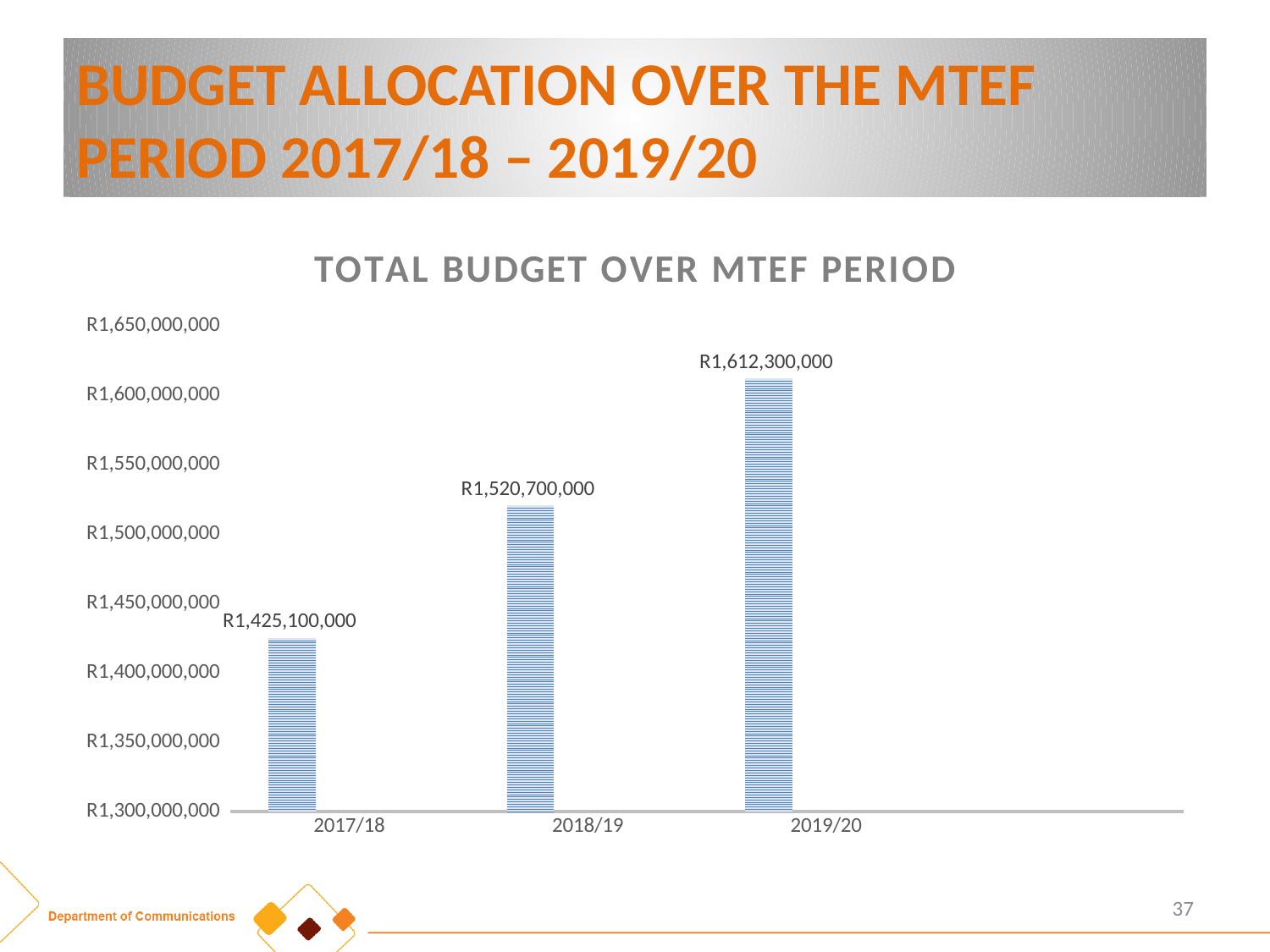
What is the difference between the 2018/19 budget and the 2017/18 budget? R95,600,000 Which financial year has the lowest total budget? 2017/18 Which financial year has the highest total budget? 2019/20 Is the value for 2018/19 greater or less than R1,500,000,000? greater What is the total budget for 2017/18? R1,425,100,000 What is the difference between the 2019/20 budget and the 2017/18 budget? R187,200,000 How many financial years are shown on the chart? 3 What kind of chart is shown on the slide? Bar chart What is the total budget for 2019/20? R1,612,300,000 What is the total budget for 2018/19? R1,520,700,000 Does the total budget rise or fall from 2017/18 to 2019/20? Rise Which is larger, the budget for 2018/19 or the budget for 2019/20? 2019/20